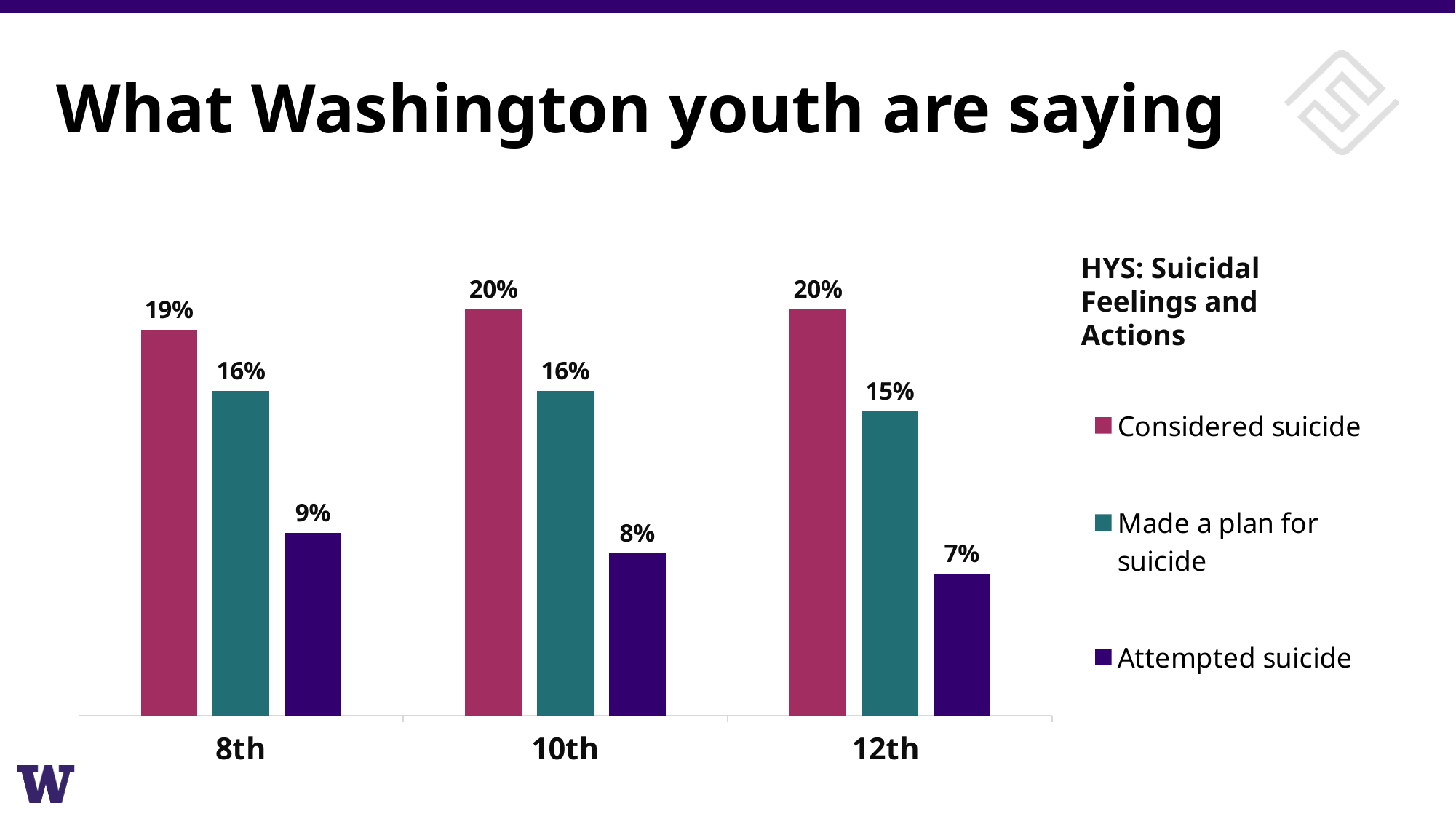
What is the difference between 'Considered suicide' and 'Attempted suicide' for 12th graders? 13% Which is larger: 'Attempted suicide' for 8th graders or for 12th graders? 8th graders Which grade has the lowest value for 'Considered suicide'? 8th What percentage of 10th graders attempted suicide? 8% Which grade has the lowest value for 'Attempted suicide'? 12th How many series does the legend list? 3 What percentage of 8th graders considered suicide? 19% Does the 'Attempted suicide' series rise or fall from 8th to 12th grade? Fall What is the value for 'Made a plan for suicide' among 12th graders? 15% What kind of chart is shown on the slide? Bar chart How many grade categories are shown on the x axis? 3 What is the difference between 'Made a plan for suicide' for 8th graders and 12th graders? 1%